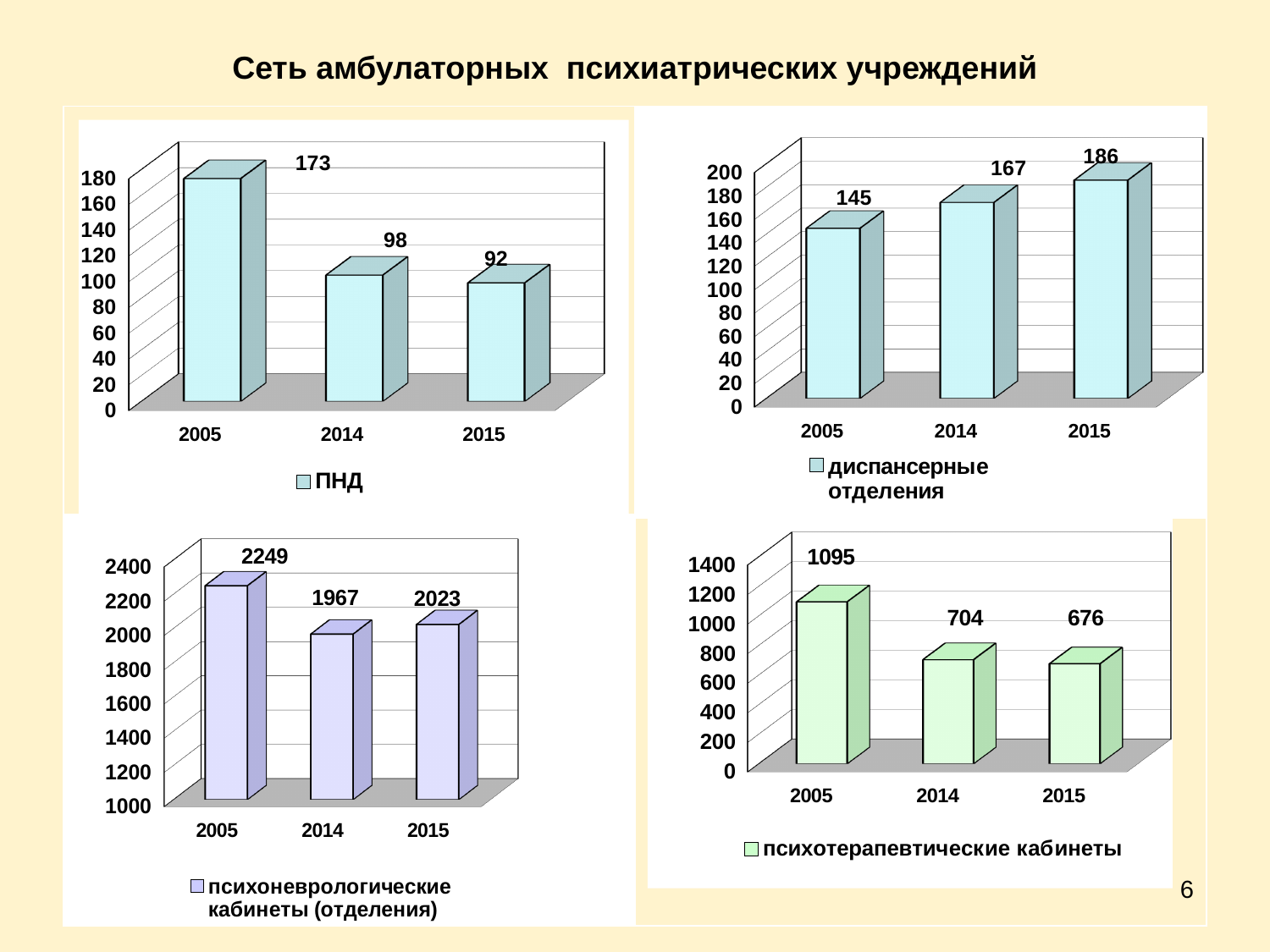
In the top-left chart (ПНД), what is the value for 2005? 173 In the bottom-right chart (психотерапевтические кабинеты), what is the difference between the 2014 and 2015 values? 28 In the bottom-left chart (психоневрологические кабинеты (отделения)), which year has the highest value? 2005 In the top-right chart (диспансерные отделения), do the values rise or fall from 2005 to 2015? rise In the top-left chart (ПНД), which year has the lowest value? 2015 In the bottom-right chart (психотерапевтические кабинеты), what is the value for 2005? 1095 In the top-right chart (диспансерные отделения), what is the difference between the 2015 and 2005 values? 41 In the bottom-left chart (психоневрологические кабинеты (отделения)), what is the value for 2014? 1967 What kind of chart is the bottom-right chart (психотерапевтические кабинеты)? bar chart In the top-right chart (диспансерные отделения), what is the value for 2015? 186 How many years (categories) are shown in the top-left chart (ПНД)? 3 In the bottom-left chart (психоневрологические кабинеты (отделения)), which is larger, the value for 2014 or 2015? 2015